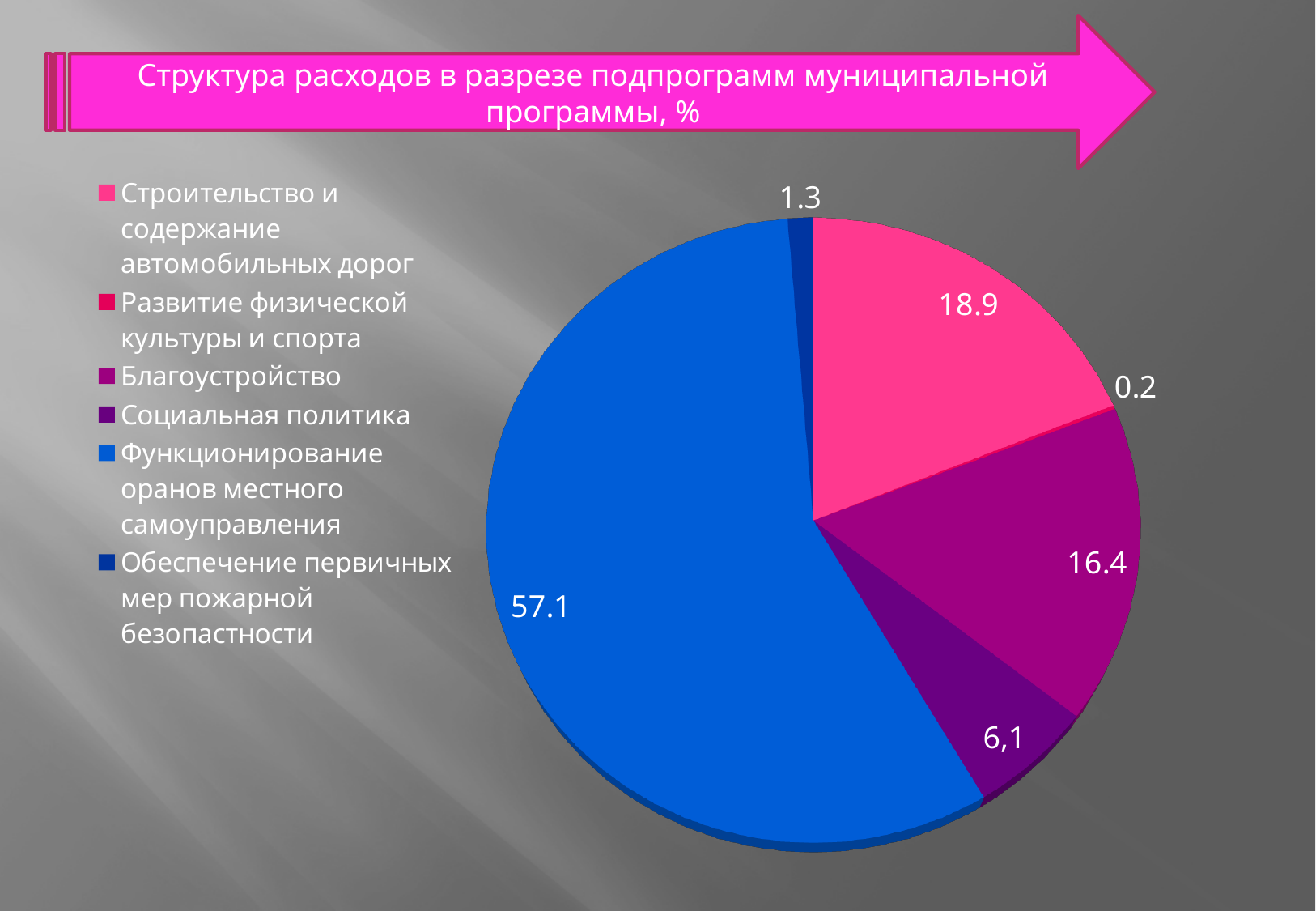
What is the value for Функционирование оранов местного самоуправления? 57.1 Which category has the smallest slice of the pie? Развитие физической культуры и спорта What is the value for Социальная политика? 6,1 Which category has the largest slice of the pie? Функционирование оранов местного самоуправления What is the value for Развитие физической культуры и спорта? 0.2 What is the value for Благоустройство? 16.4 What is the value for Обеспечение первичных мер пожарной безопастности? 1.3 What kind of chart is shown on the slide? pie chart Which is larger: the value for Социальная политика or the value for Обеспечение первичных мер пожарной безопастности? Социальная политика How many categories does the legend list? 6 What is the value for Строительство и содержание автомобильных дорог? 18.9 What is the difference between the values for Строительство и содержание автомобильных дорог and Благоустройство? 2.5